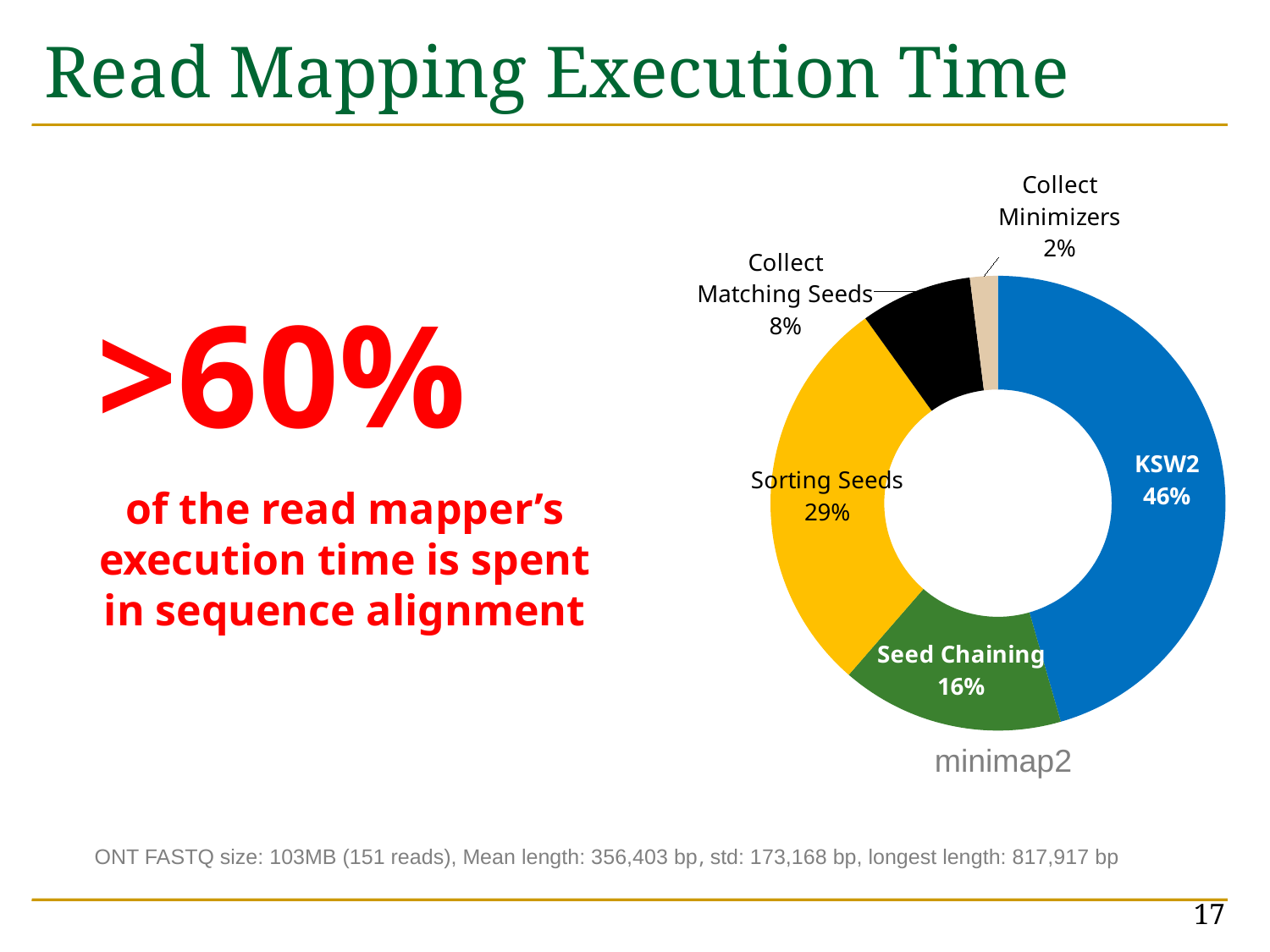
What percentage of execution time is attributed to Sorting Seeds? 29% Which stage accounts for the smallest share of execution time? Collect Minimizers What is the combined share of Seed Chaining and Sorting Seeds? 45% How many stages are shown in the chart? 5 What is the value shown for Seed Chaining? 16% What share of minimap2's execution time is spent in KSW2? 46% Which stage accounts for the largest share of execution time? KSW2 How many percentage points larger is KSW2's share than Sorting Seeds' share? 17 What percentage is shown for Collect Matching Seeds? 8% Which has a larger share: Seed Chaining or Collect Matching Seeds? Seed Chaining What kind of chart is shown on the slide? Doughnut chart Which read mapper is the chart about, according to the label below it? minimap2